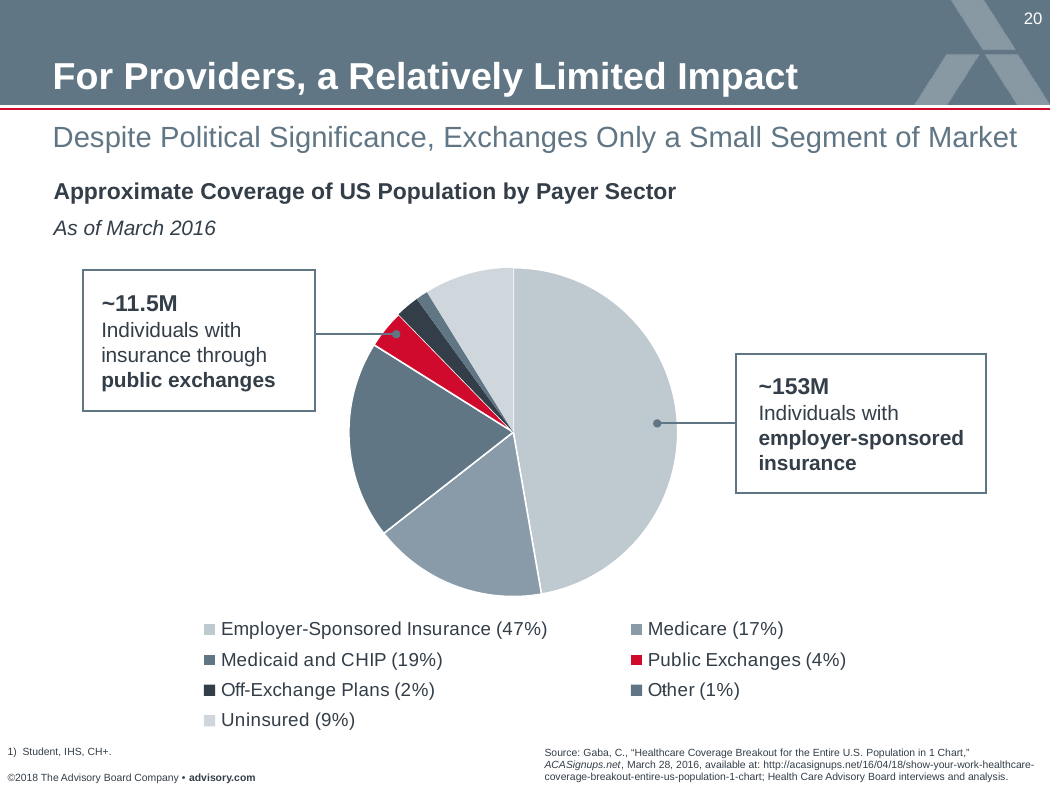
What is the combined share of Public Exchanges and Off-Exchange Plans? 6% Which payer sector has the smallest share of the pie? Other What share of the pie does Employer-Sponsored Insurance represent? 47% What is the difference in percentage points between Medicaid and CHIP and Medicare? 2 percentage points What percentage is shown for Medicare? 17% What percentage is shown for Medicaid and CHIP? 19% What is the title of the chart? Approximate Coverage of US Population by Payer Sector Which payer sector has the largest share of the pie? Employer-Sponsored Insurance What kind of chart is shown on the slide? pie chart Which is larger, the share for Uninsured or the share for Public Exchanges? Uninsured How many payer sectors are listed in the legend? 7 As of what date is the chart data reported? March 2016